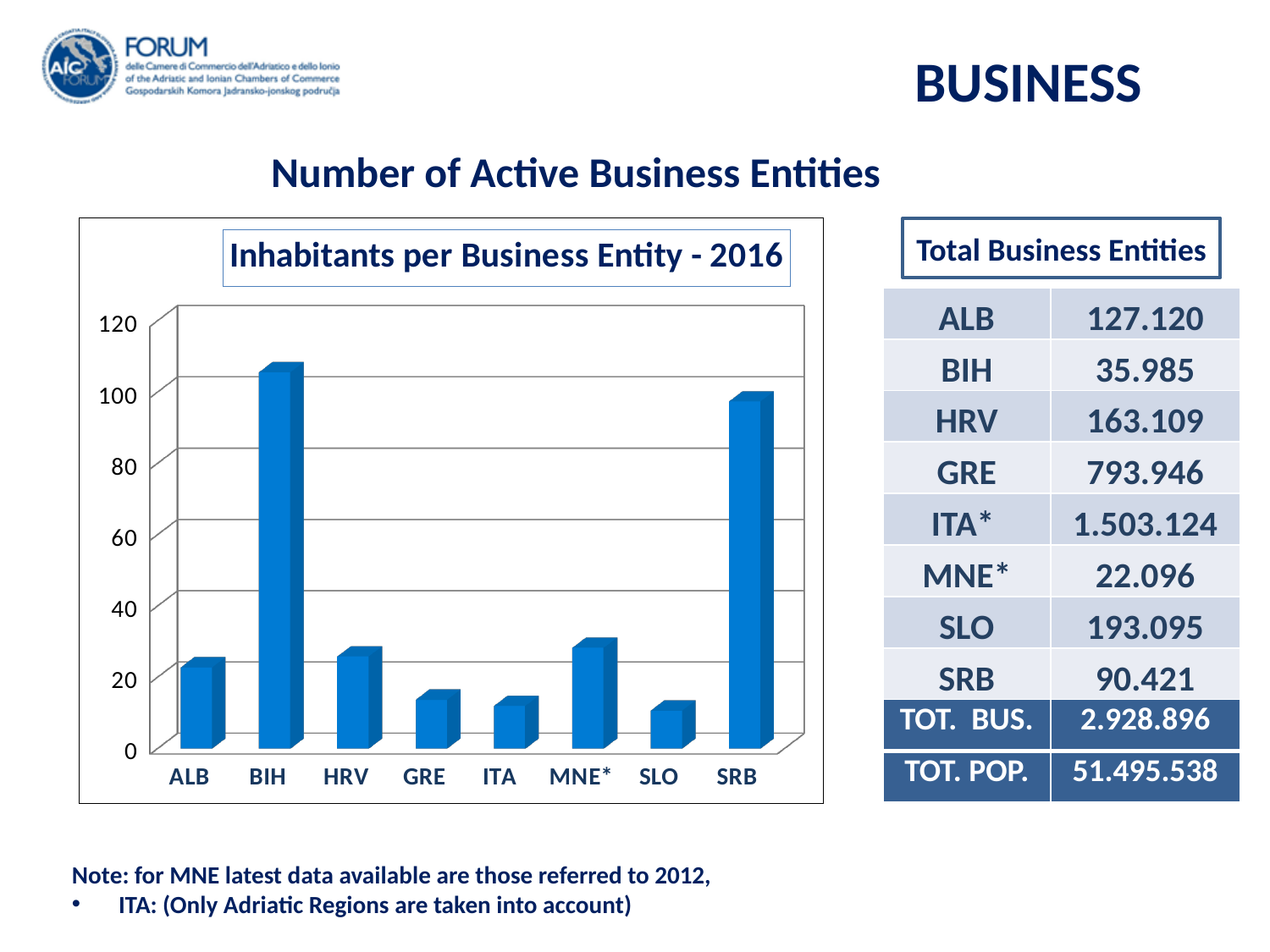
Is the value for HRV greater or less than 40? less What kind of chart is shown on the slide? bar chart Which has a higher value in the chart, MNE* or ITA? MNE* What is the title of the chart? Inhabitants per Business Entity - 2016 Is the value for BIH greater or less than 100? greater Is the value for MNE* greater or less than 40? less Which has a higher value in the chart, BIH or SRB? BIH Which country has the highest number of inhabitants per business entity in the chart? BIH How many countries are shown on the x axis of the chart? 8 Which has a higher value in the chart, ALB or GRE? ALB